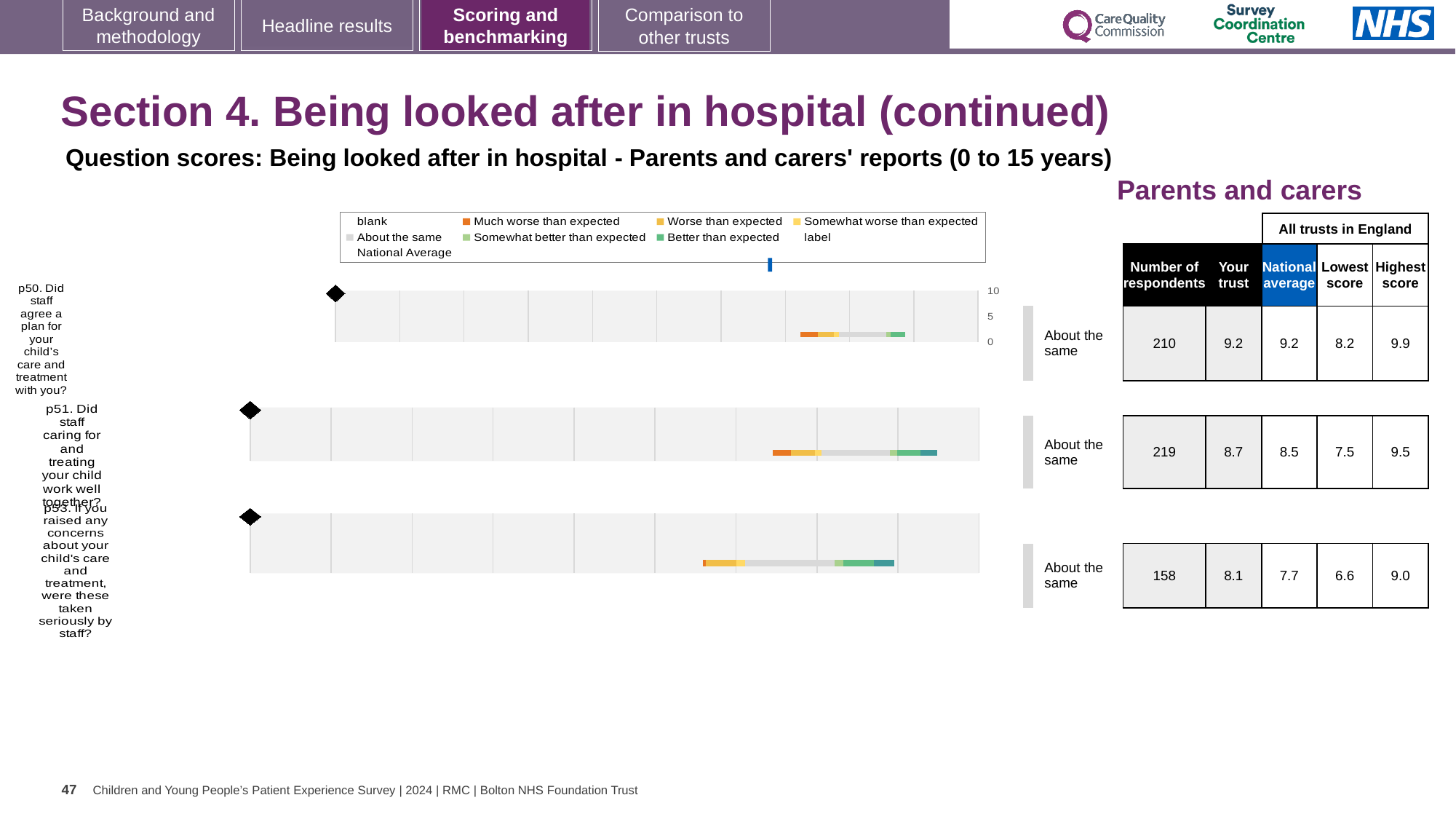
What benchmark category is shown beside the chart for p50? About the same What kind of chart is used to show the question scores on this slide? bar chart What colour does the legend use for 'Much worse than expected'? orange In the table next to the charts, what is the 'Your trust' score for p50 (Did staff agree a plan for your child's care and treatment with you?)? 9.2 For p53, what is the difference between the 'Your trust' score and the national average? 0.4 How many survey questions are plotted in the benchmarking charts on this slide? 3 In the table next to the charts, what is the national average for p51 (Did staff caring for and treating your child work well together?)? 8.5 Which of the three plotted questions has the largest number of respondents? p51 In the table next to the charts, how many respondents are recorded for p53 (If you raised any concerns about your child's care and treatment, were these taken seriously by staff?)? 158 In the table next to the charts, what is the highest score across all trusts in England for p50? 9.9 Which of the three plotted questions has the lowest 'Lowest score' across all trusts in England? p53 For p51, is the 'Your trust' score or the national average larger? Your trust